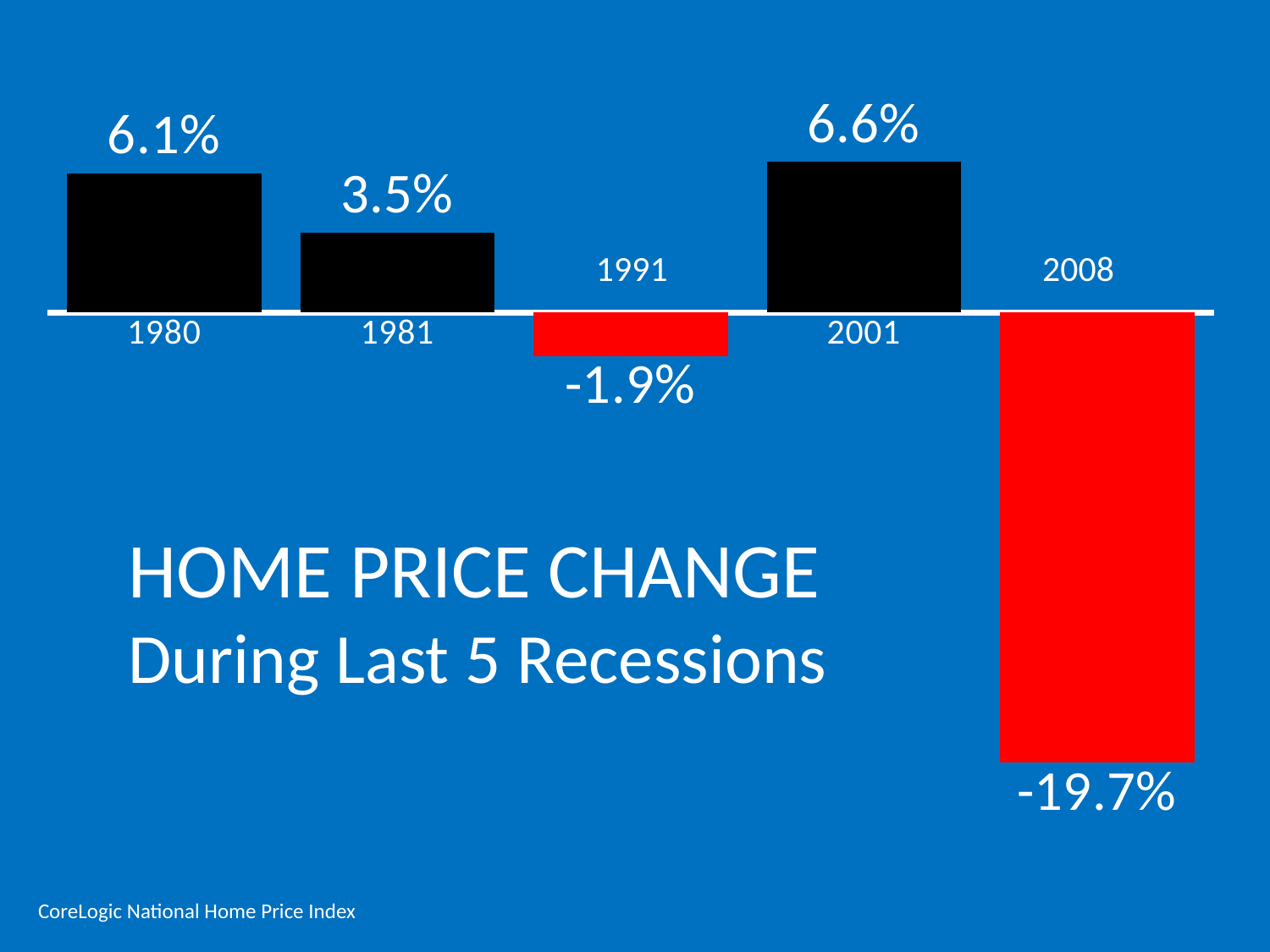
Which recession year shows the highest home price change? 2001 How many of the recession years show a negative home price change? 2 What is the difference between the home price change in 2001 and in 1981? 3.1% What colour are the bars for years with a negative home price change? Red Which recession year shows the lowest home price change? 2008 Which year has the larger home price change, 1980 or 1981? 1980 What is the source cited for the chart data? CoreLogic National Home Price Index How many recession years are shown in the chart? 5 What is the home price change shown for 2008? -19.7% What is the home price change shown for 1980? 6.1% What kind of chart is shown on the slide? Bar chart What is the home price change shown for 1991? -1.9%